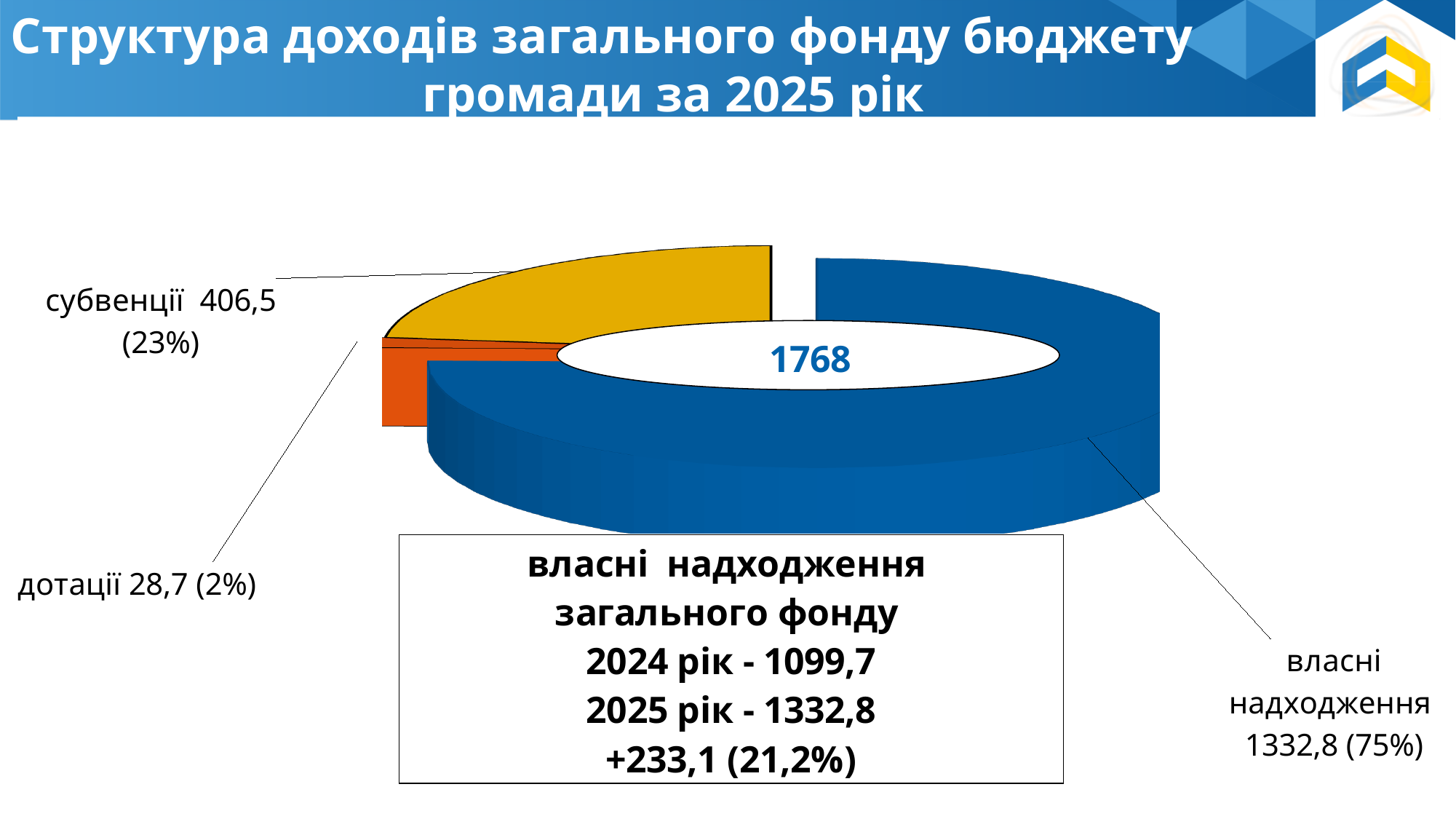
How many slices does the chart have? 3 What is the value for субвенції? 406,5 What is the title of the slide containing the chart? Структура доходів загального фонду бюджету громади за 2025 рік What kind of chart is shown on the slide? doughnut (pie) chart What is the value for дотації? 28,7 What share of the chart does субвенції represent? 23% Which category has the smallest slice? дотації What is the value for власні надходження? 1332,8 Which category has the largest slice? власні надходження What is the difference between the values for власні надходження and субвенції? 926,3 What total is shown in the centre of the doughnut chart? 1768 What share of the chart does власні надходження represent? 75%